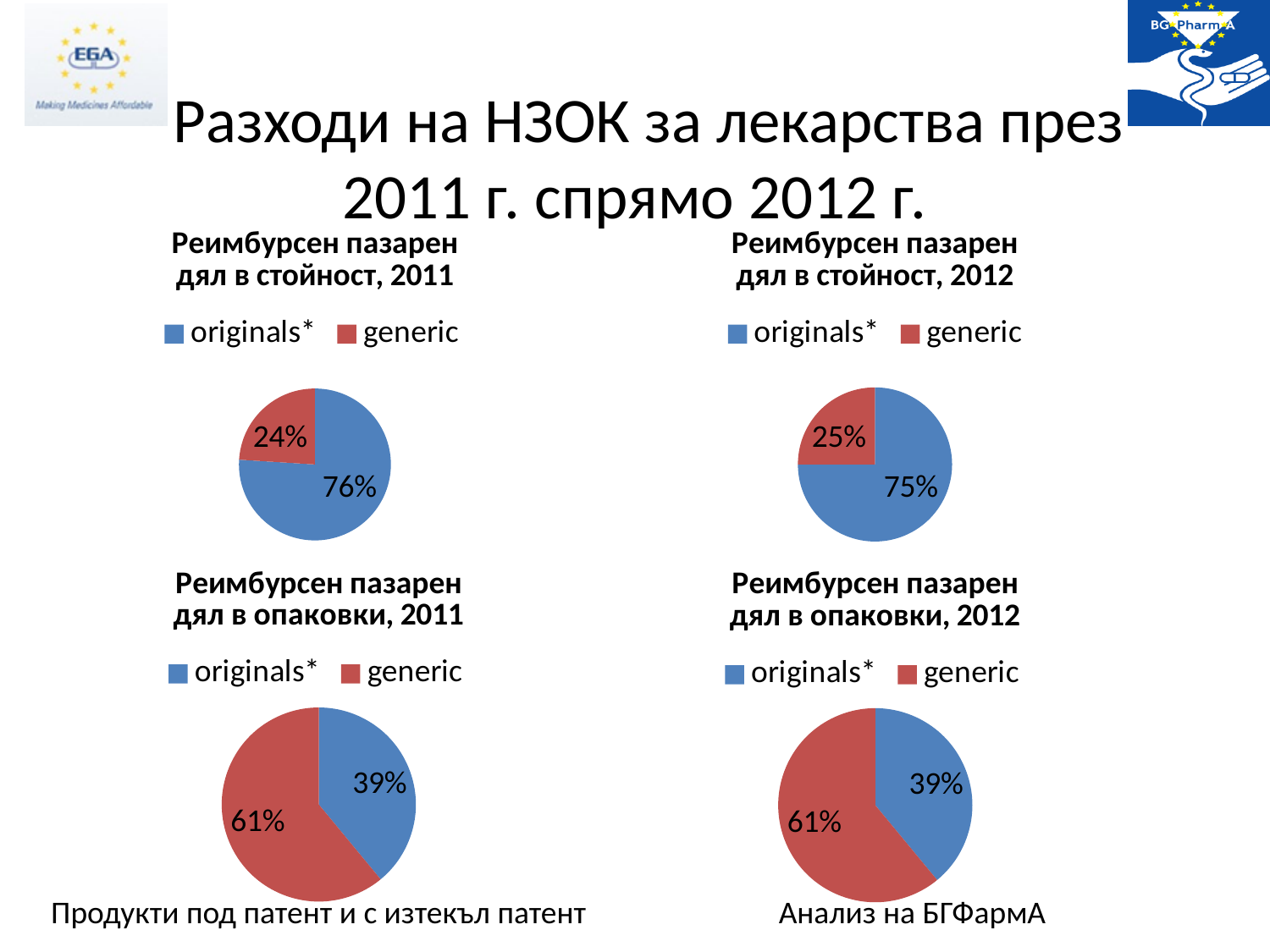
In the chart titled "Реимбурсен пазарен дял в опаковки, 2012", what share does originals* have? 39% In the chart titled "Реимбурсен пазарен дял в опаковки, 2011", what share does generic have? 61% What type of chart is the chart titled "Реимбурсен пазарен дял в опаковки, 2011"? pie chart In the chart titled "Реимбурсен пазарен дял в опаковки, 2011", which is larger, originals* or generic? generic In the chart titled "Реимбурсен пазарен дял в стойност, 2012", what share does originals* have? 75% In the chart titled "Реимбурсен пазарен дял в стойност, 2011", what share does generic have? 24% In the chart titled "Реимбурсен пазарен дял в стойност, 2012", what is the difference between the originals* share and the generic share? 50% In the chart titled "Реимбурсен пазарен дял в стойност, 2012", what share does generic have? 25% In the chart titled "Реимбурсен пазарен дял в стойност, 2011", what share does originals* have? 76% In the chart titled "Реимбурсен пазарен дял в стойност, 2011", which category has the largest slice? originals* How many entries does the legend of the chart titled "Реимбурсен пазарен дял в стойност, 2012" list? 2 In the chart titled "Реимбурсен пазарен дял в опаковки, 2012", which category has the smallest slice? originals*